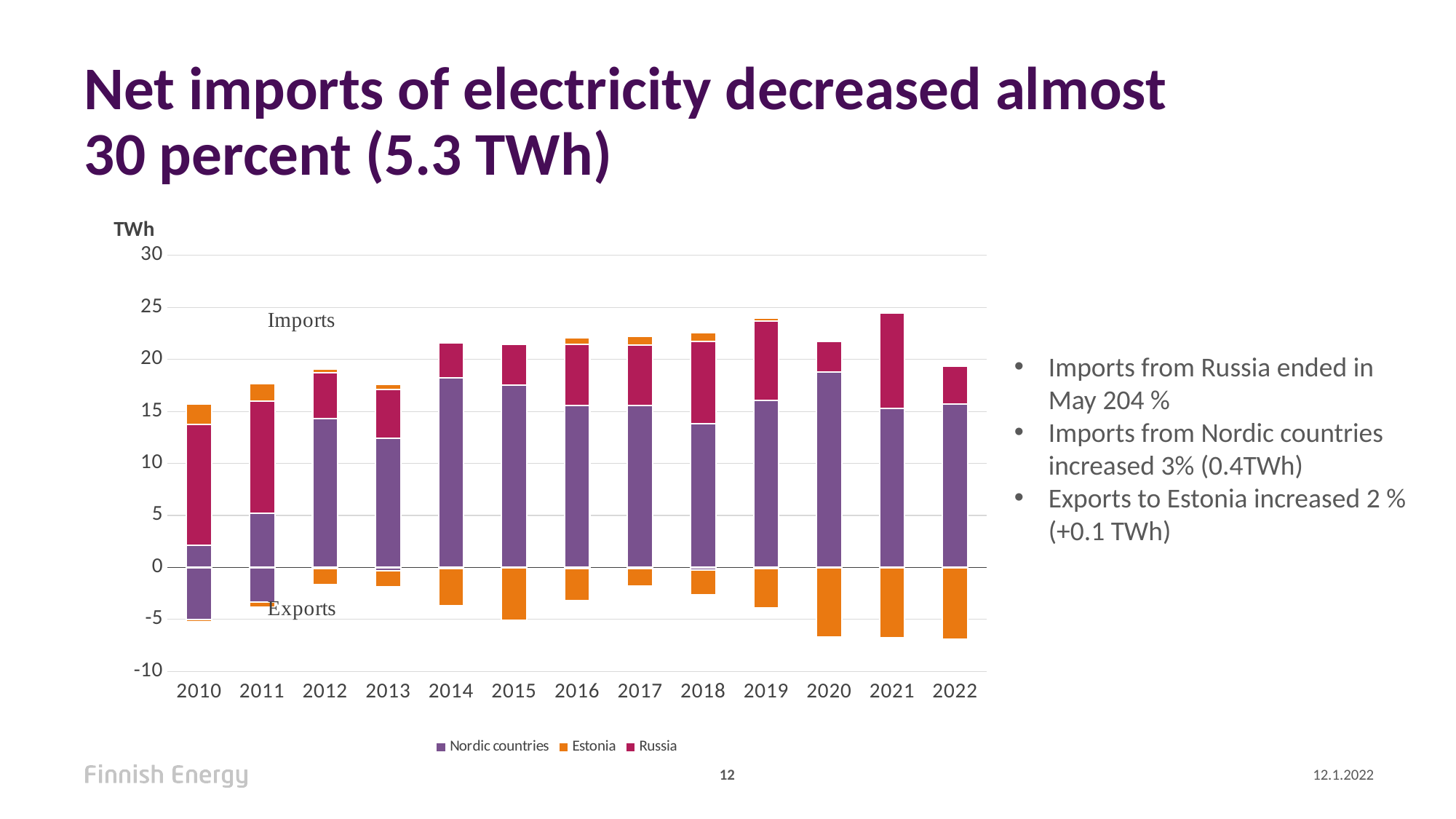
How many series does the chart legend list? 3 What kind of chart is shown on the slide? Stacked bar chart Is the total import stack for 2010 greater or less than 20 TWh? less Which year has the shortest import stack (above zero)? 2010 Which series are listed in the chart legend? Nordic countries, Estonia, Russia Is the Nordic countries import segment larger in 2020 or in 2010? 2020 Is the total import stack for 2021 greater or less than 20 TWh? greater How many years are shown along the x axis of the chart? 13 What unit is shown on the vertical axis of the chart? TWh Is the export value (below zero) for 2020 greater or less than -5 TWh? less Is the Russia import segment larger in 2010 or in 2022? 2010